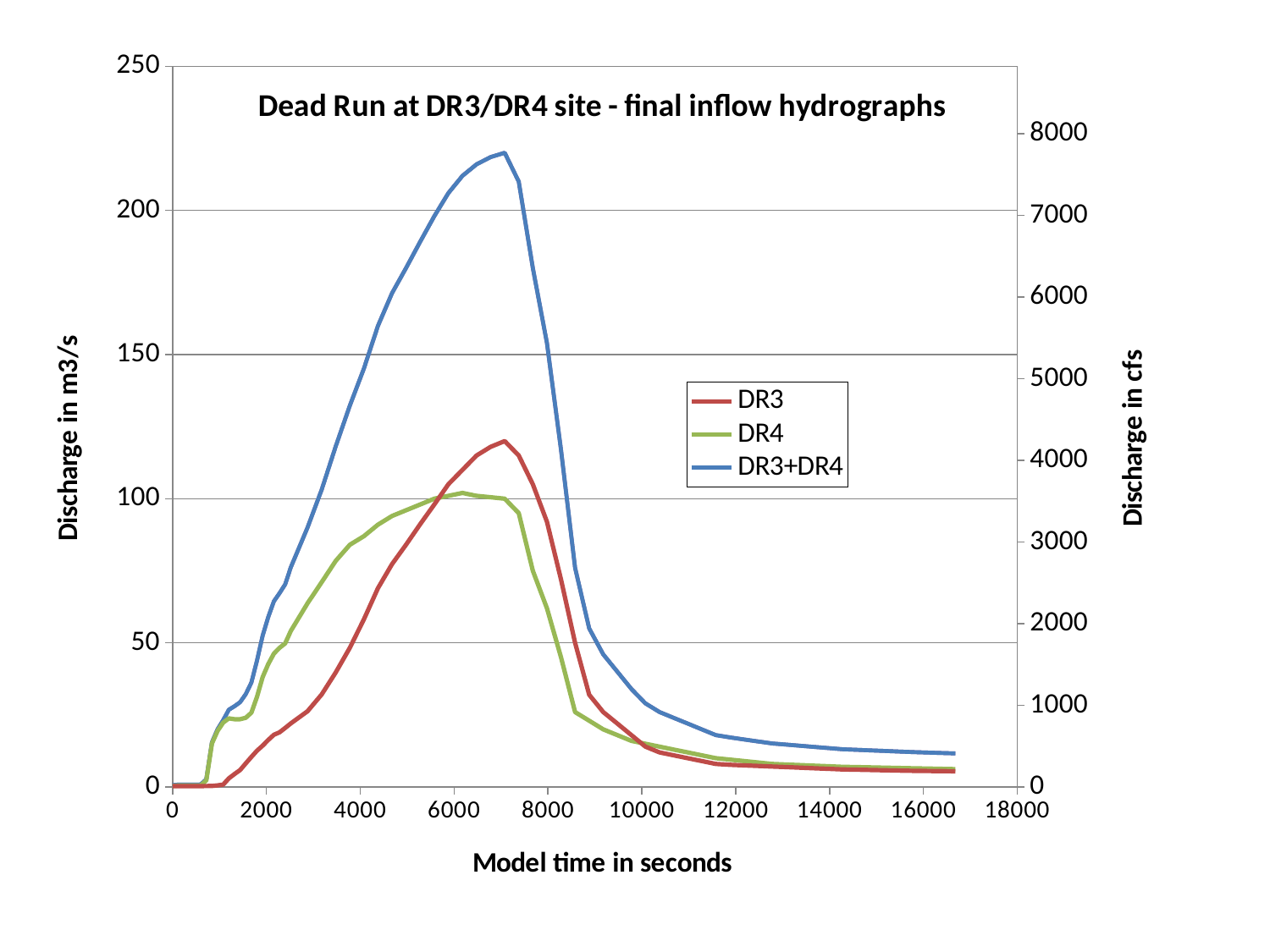
What is the label of the x axis? Model time in seconds What kind of chart is shown on the slide? line chart At a model time of 4000 seconds, is the DR4 value greater or less than 100 m3/s? less Is the peak value of the DR3 series greater or less than 100 m3/s on the left axis? greater Between model times of 8000 and 12000 seconds, does the DR3+DR4 series rise or fall? fall What is the title of the chart? Dead Run at DR3/DR4 site - final inflow hydrographs Which series reaches the highest peak discharge? DR3+DR4 At a model time of 4000 seconds, which series has the larger value, DR3 or DR4? DR4 How many series does the legend list? 3 Is the peak value of the DR3+DR4 series greater or less than 200 m3/s on the left axis? greater At a model time of 7000 seconds, which series has the larger value, DR3 or DR4? DR3 Which of DR3 and DR4 reaches the higher peak discharge? DR3